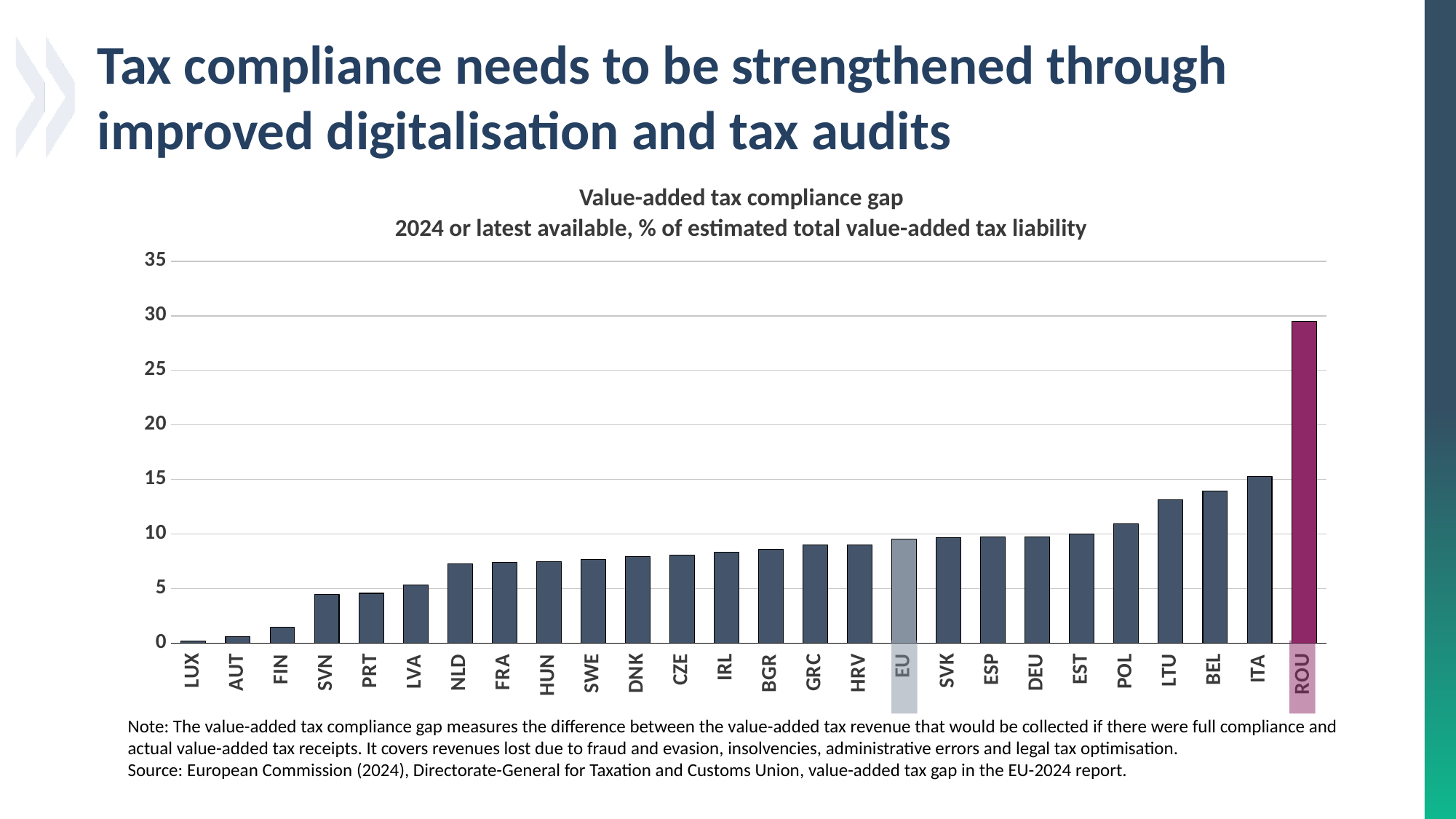
Which country has the highest value-added tax compliance gap? ROU Do the bar values rise or fall from left to right along the x axis? rise Is the value for LTU greater or less than 10? greater Is the value for ROU greater or less than 25? greater Which country has the lowest value-added tax compliance gap? LUX Which has a larger value-added tax compliance gap, ROU or ITA? ROU What is the title of the chart? Value-added tax compliance gap Is the value for SVN greater or less than 5? less How many bars are plotted in the chart? 26 Which has a larger value-added tax compliance gap, FIN or AUT? FIN What kind of chart is shown on the slide? bar chart